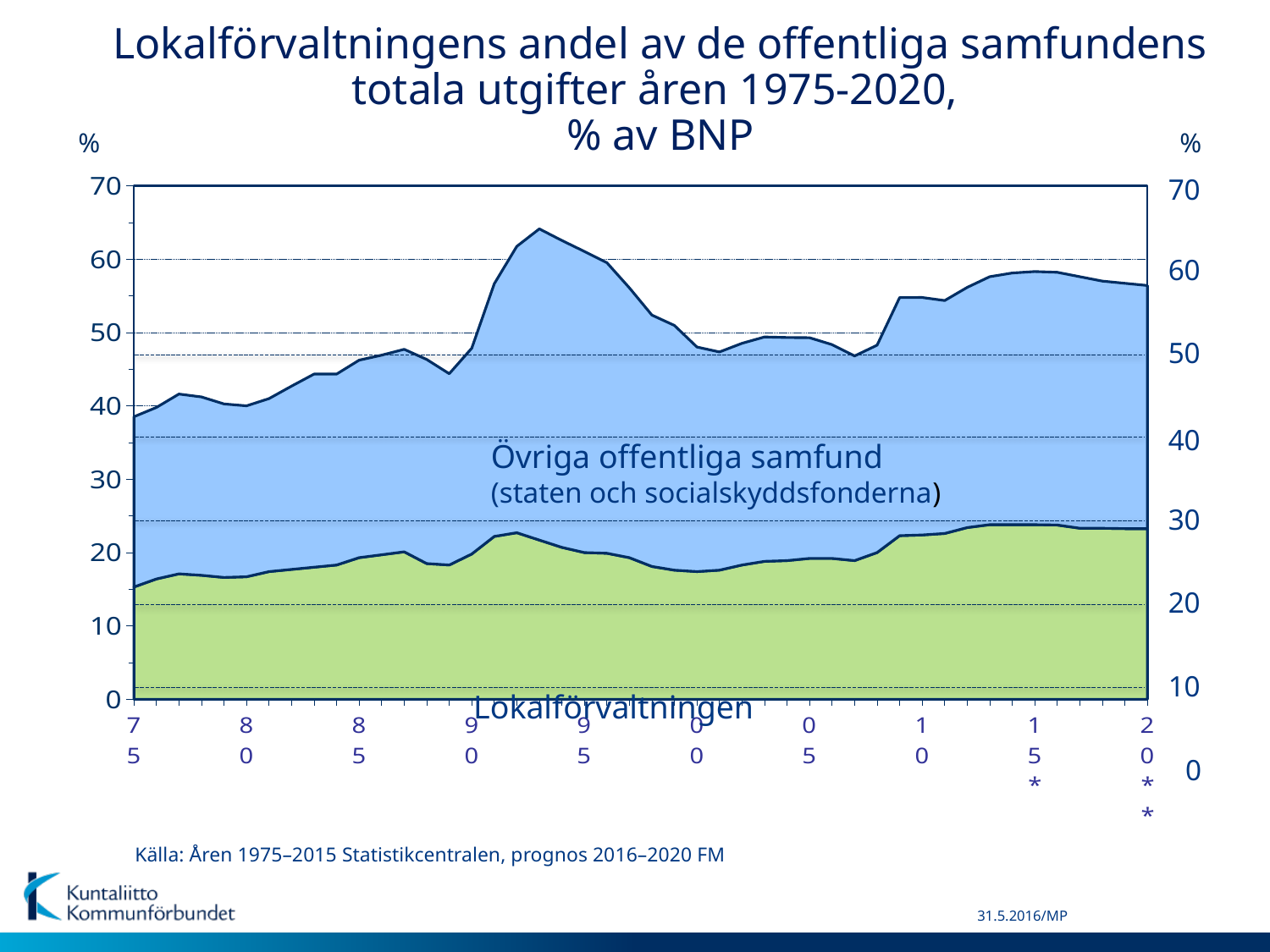
How many series are plotted in the chart? 2 Does the value for Lokalförvaltningen rise or fall overall from 1975 to 2020? rise What kind of chart is shown on the slide? Stacked area chart Is the value for Lokalförvaltningen in 2020 greater or less than 20? greater Which series is shown in green at the bottom of the chart? Lokalförvaltningen In 2020, which series has the larger value, Lokalförvaltningen or Övriga offentliga samfund? Övriga offentliga samfund Is the value for Lokalförvaltningen in 1975 greater or less than 20? less Is the combined total of both series at its peak around 1993 greater or less than 60? greater Does the combined total of both series rise or fall from its peak around 1993 to 2000? fall What is the unit shown on the y axis of the chart? %